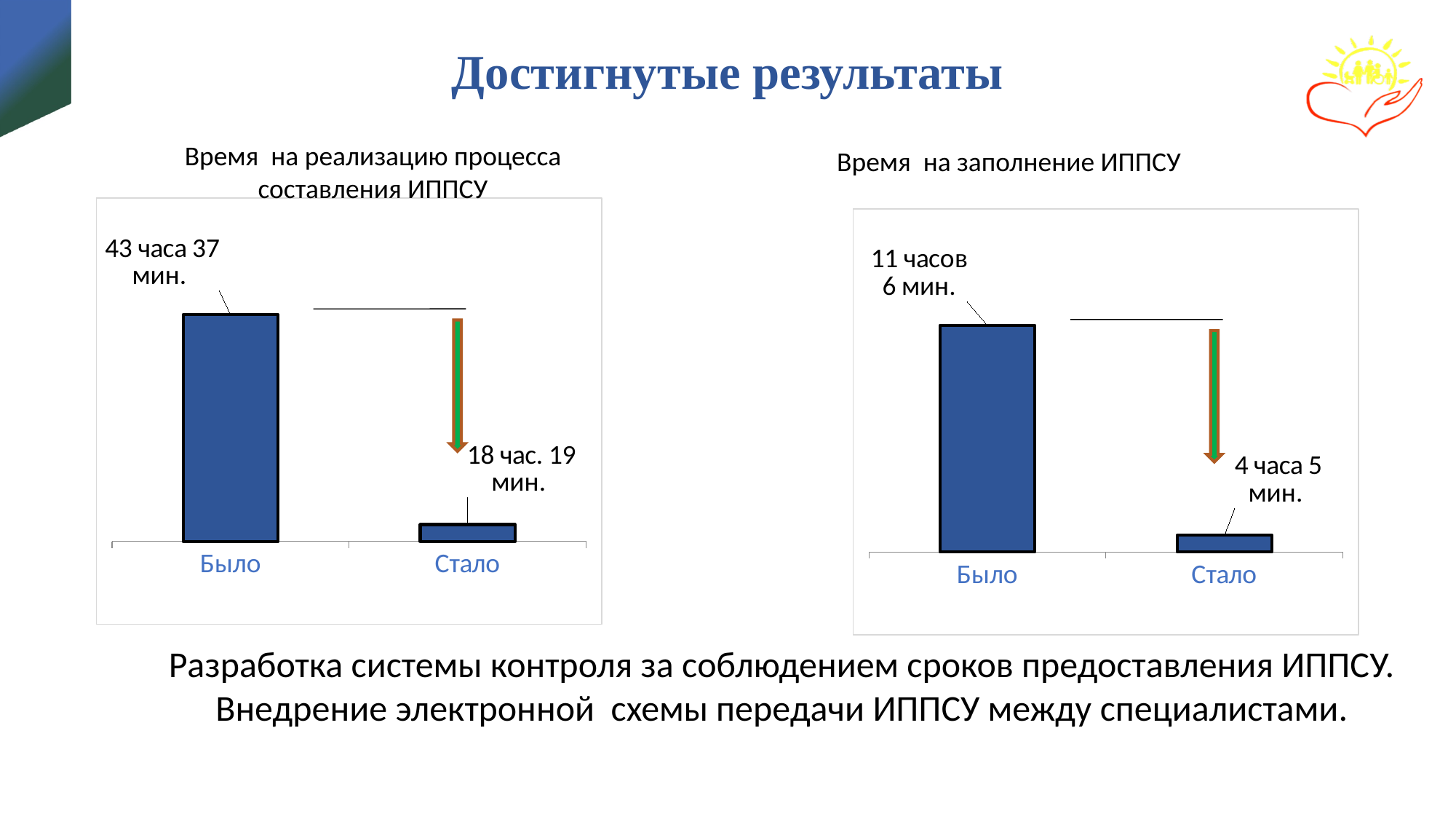
In the right chart, which category has the lowest value? Стало In the chart titled «Время на заполнение ИППСУ», what is the value for «Стало»? 4 часа 5 мин. In the chart titled «Время на реализацию процесса составления ИППСУ», what is the value for «Было»? 43 часа 37 мин. In the left chart, which category has the highest value? Было How many categories are shown in the chart titled «Время на заполнение ИППСУ»? 2 In the left chart, which category has the higher value, «Было» or «Стало»? Было What type of chart is the left chart on the slide? Bar chart In the right chart, do the values rise or fall from «Было» to «Стало»? Fall In the chart titled «Время на реализацию процесса составления ИППСУ», what is the value for «Стало»? 18 час. 19 мин. In the chart titled «Время на заполнение ИППСУ», what is the difference between the «Было» and «Стало» values? 7 часов 1 мин. What is the title of the right chart on the slide? Время на заполнение ИППСУ In the chart titled «Время на заполнение ИППСУ», what is the value for «Было»? 11 часов 6 мин.